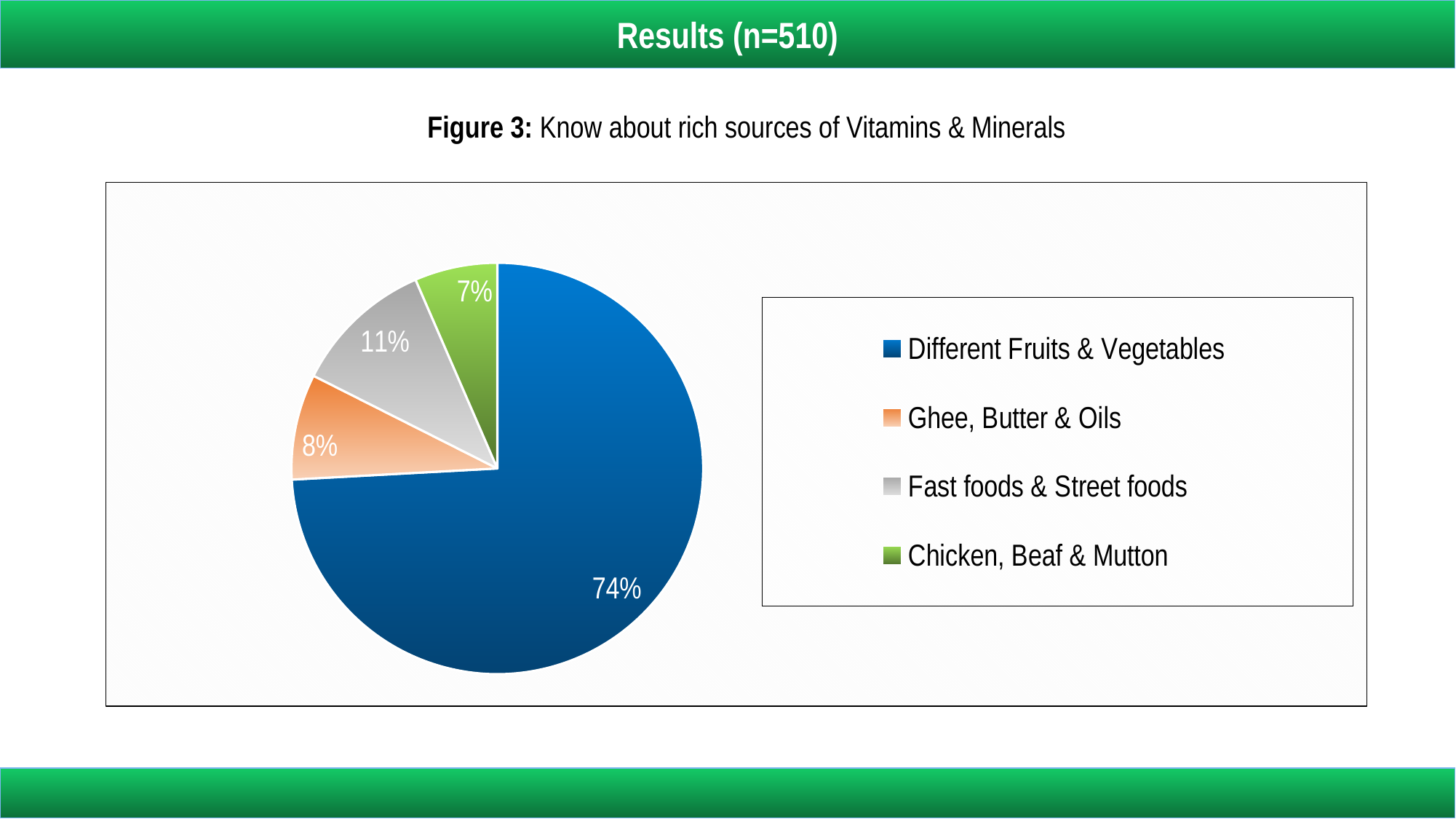
Which category has the largest slice of the pie? Different Fruits & Vegetables What is the figure caption above the chart? Figure 3: Know about rich sources of Vitamins & Minerals Which category has the smallest slice of the pie? Chicken, Beaf & Mutton What percentage is shown for Ghee, Butter & Oils? 8% What is the difference in percentage points between Different Fruits & Vegetables and Fast foods & Street foods? 63 What percentage is shown for Fast foods & Street foods? 11% Which is larger: the slice for Fast foods & Street foods or the slice for Ghee, Butter & Oils? Fast foods & Street foods What colour is the slice for Different Fruits & Vegetables? blue How many categories does the pie chart have? 4 What percentage of the pie is labelled for Different Fruits & Vegetables? 74% What percentage is shown for Chicken, Beaf & Mutton? 7% What kind of chart is shown on the slide? pie chart